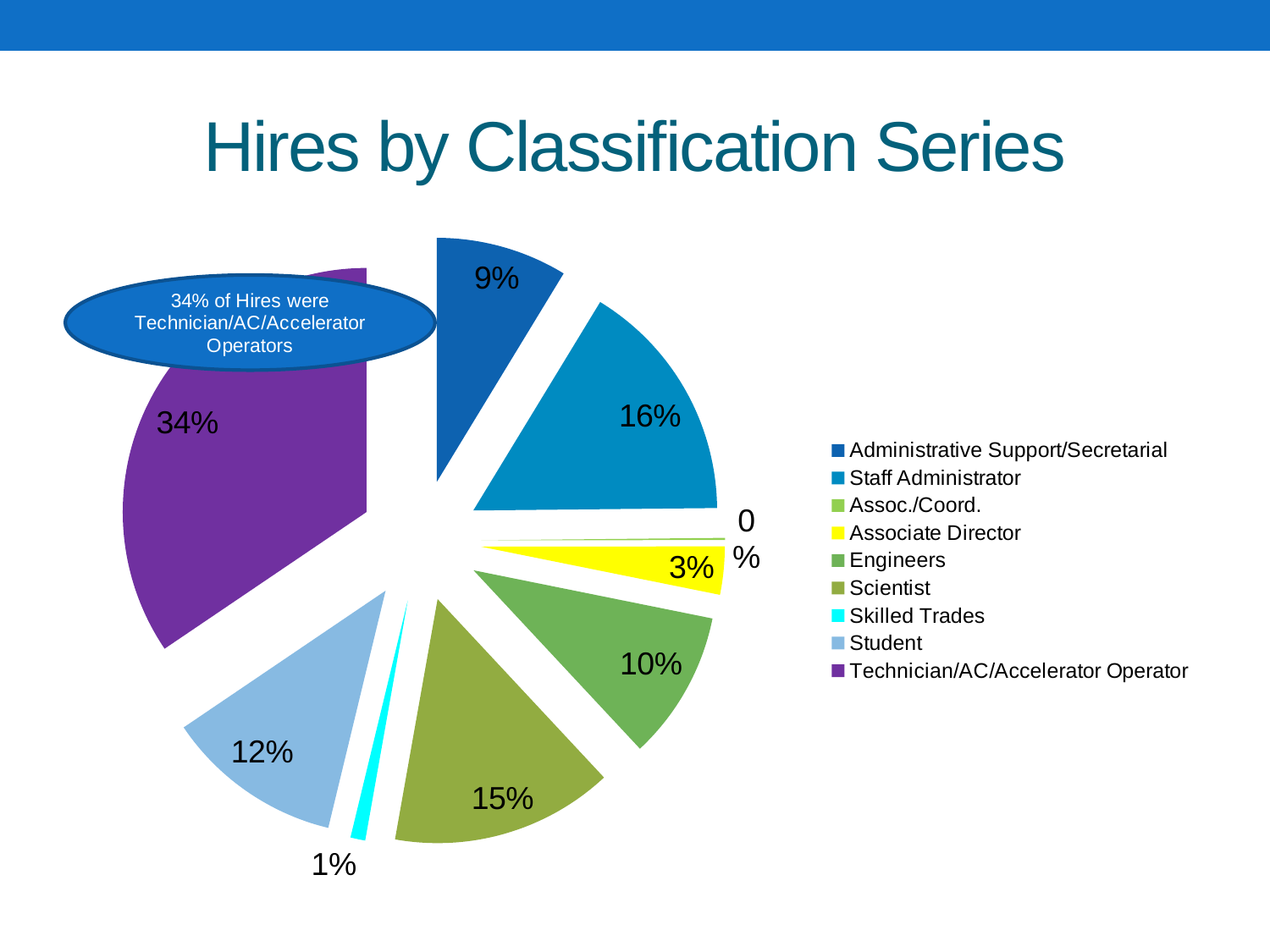
What is the title of the chart? Hires by Classification Series What share of hires were Technician/AC/Accelerator Operators? 34% What share of hires were Skilled Trades? 1% What kind of chart is shown on the slide? pie chart How many categories does the legend list? 9 What share of hires were Staff Administrators? 16% Which has a larger share of hires, Engineers or Administrative Support/Secretarial? Engineers What is the difference in percentage points between the Technician/AC/Accelerator Operator share and the Staff Administrator share? 18% Which classification has the smallest share of hires? Assoc./Coord. Which classification has the largest share of hires? Technician/AC/Accelerator Operator